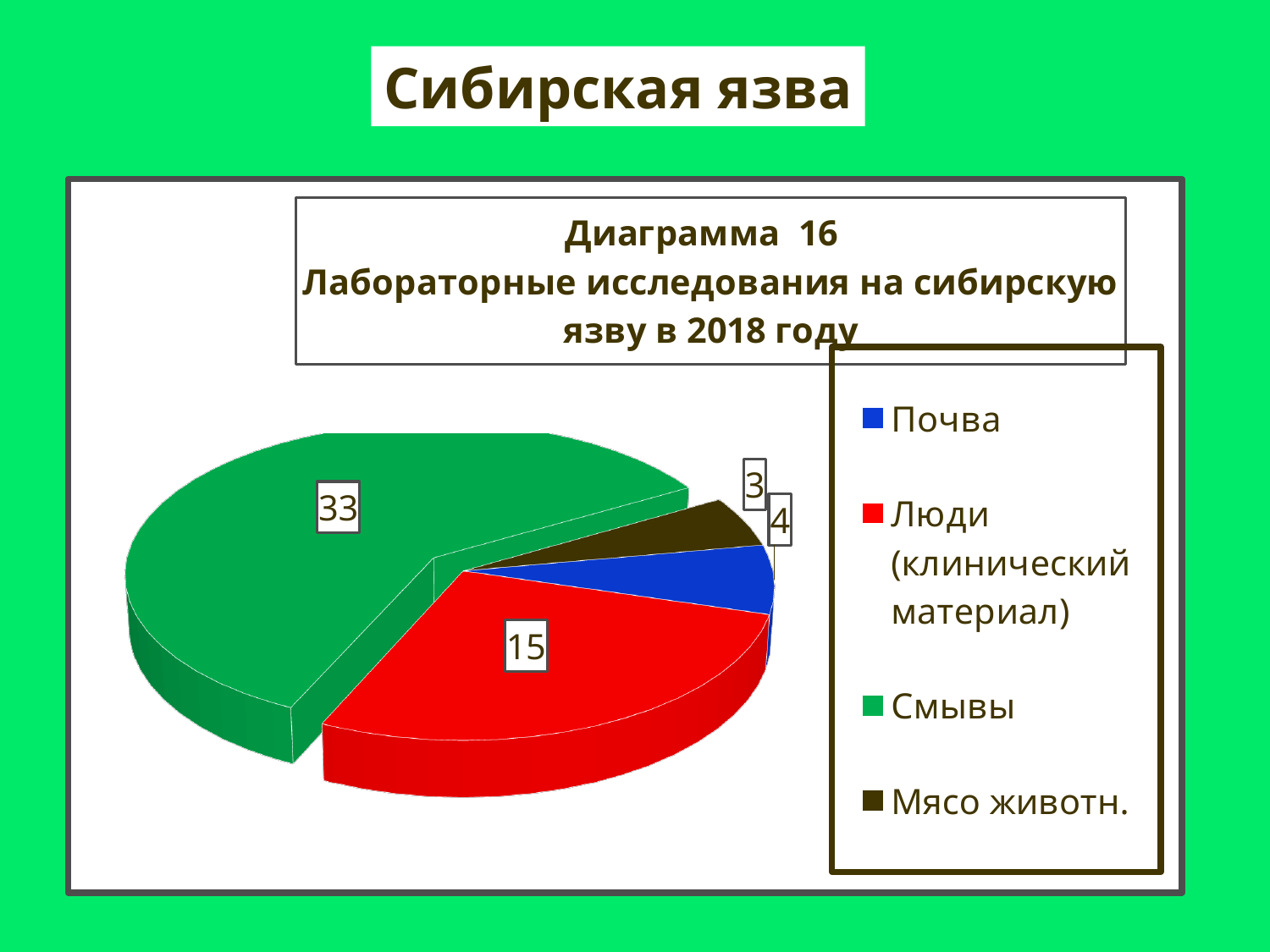
What is the total of all values in the pie chart? 55 How many categories does the pie chart have? 4 What is the value for Почва in the pie chart? 4 What is the difference between the values for Смывы and Люди (клинический материал)? 18 What is the title of the chart? Диаграмма 16 Лабораторные исследования на сибирскую язву в 2018 году What is the value for Смывы in the pie chart? 33 Which is larger, the value for Почва or the value for Мясо животн.? Почва What is the value for Люди (клинический материал) in the pie chart? 15 Which category has the smallest slice in the pie chart? Мясо животн. What type of chart is shown on the slide? pie chart What is the value for Мясо животн. in the pie chart? 3 Which category has the largest slice in the pie chart? Смывы